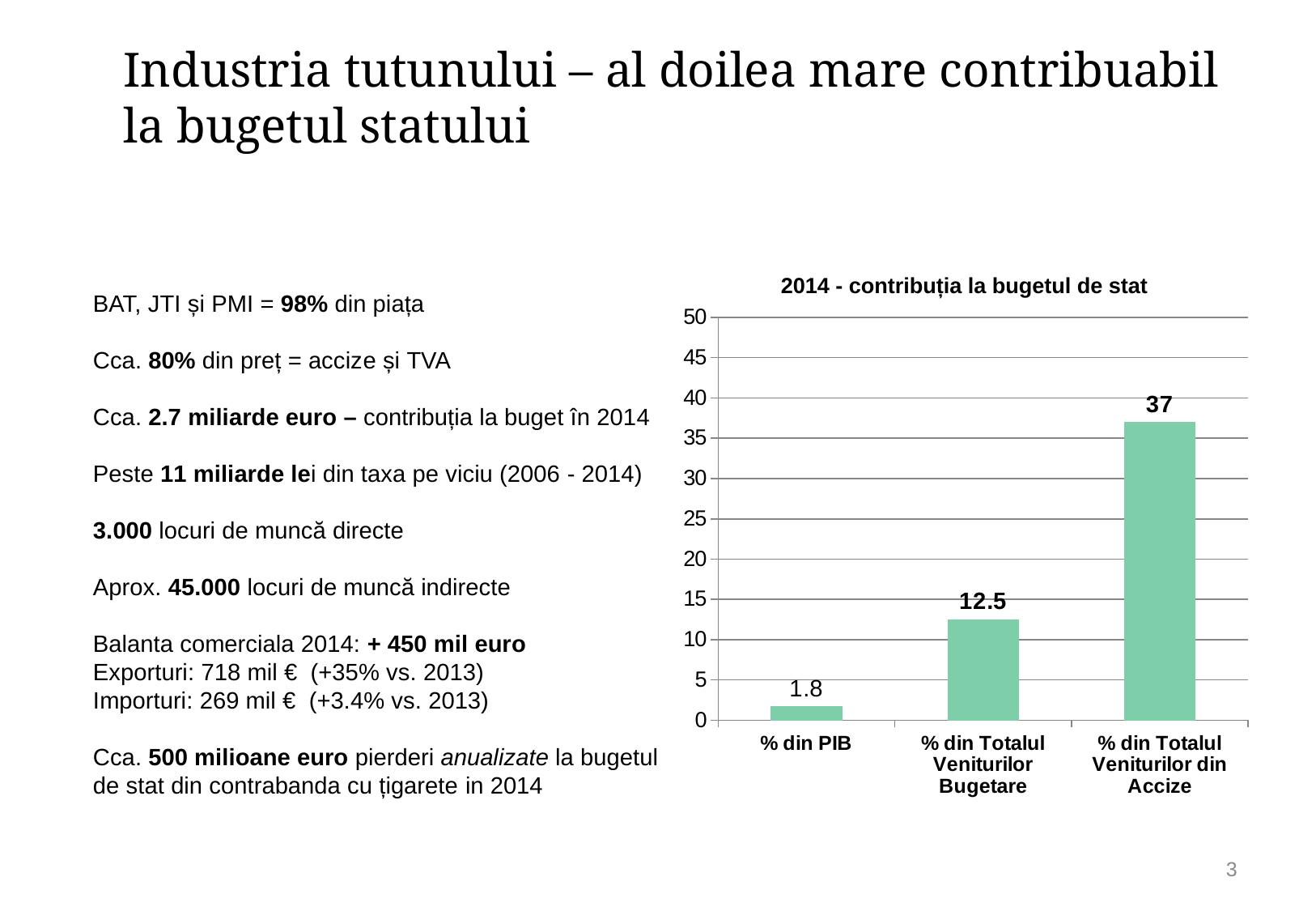
What is the value for "% din Totalul Veniturilor Bugetare"? 12.5 What kind of chart is shown on the slide? bar chart Which category has the lowest value? % din PIB Which is larger, the value for "% din PIB" or the value for "% din Totalul Veniturilor Bugetare"? % din Totalul Veniturilor Bugetare Which category has the highest value? % din Totalul Veniturilor din Accize What is the value for "% din Totalul Veniturilor din Accize"? 37 What is the difference between the values for "% din Totalul Veniturilor din Accize" and "% din Totalul Veniturilor Bugetare"? 24.5 How many categories are shown in the chart? 3 Is the value for "% din Totalul Veniturilor din Accize" greater or less than 35? greater What is the difference between the values for "% din Totalul Veniturilor Bugetare" and "% din PIB"? 10.7 What is the value for "% din PIB"? 1.8 What is the title of the chart? 2014 - contribuția la bugetul de stat